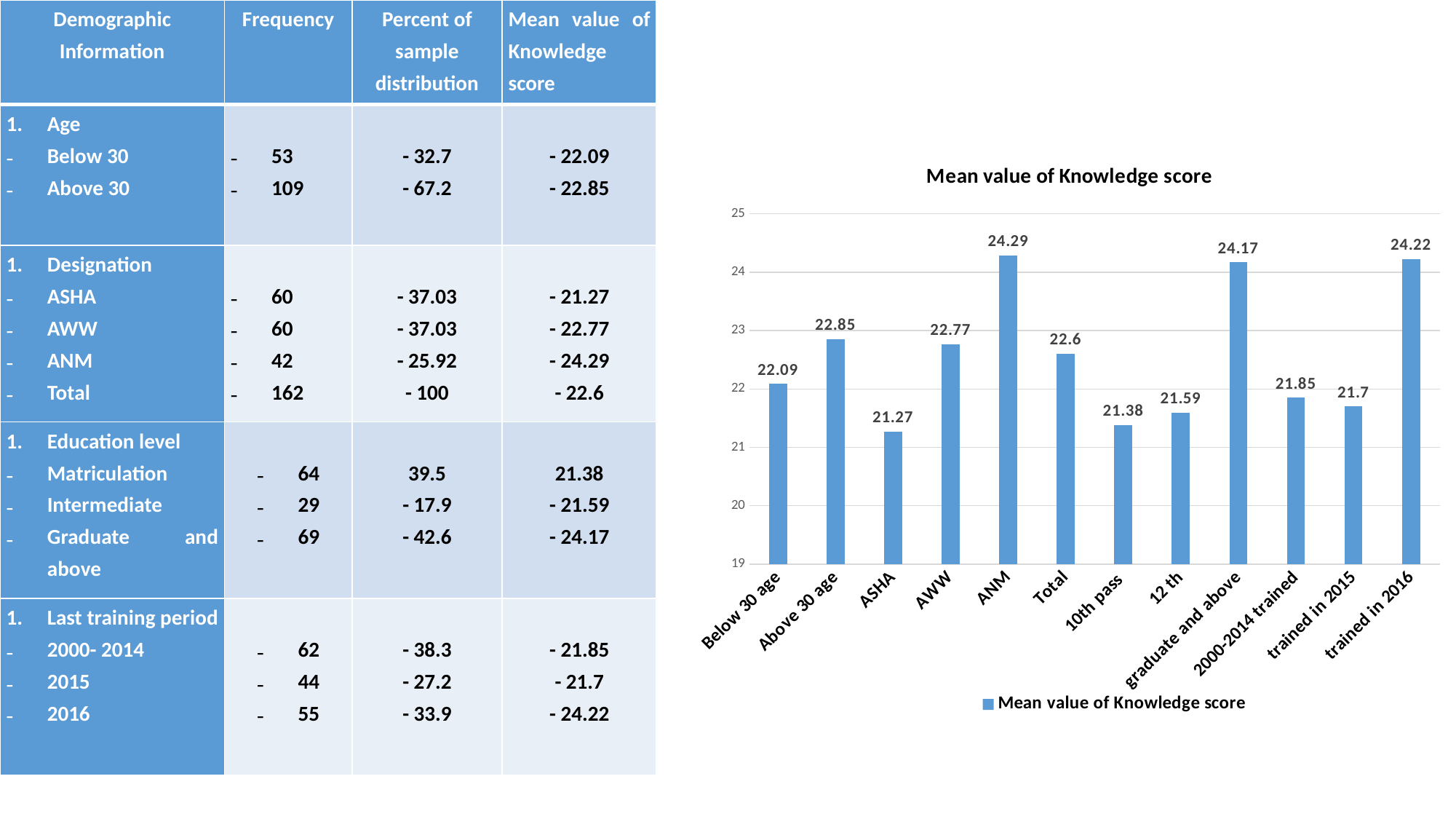
Which has a higher mean Knowledge score, AWW or ASHA? AWW Which category has the lowest mean value of Knowledge score in the chart? ASHA What type of chart is shown on the slide? bar chart How many series does the chart legend list? 1 What is the mean value of Knowledge score for 'Below 30 age' in the chart? 22.09 Which category has the highest mean value of Knowledge score in the chart? ANM What is the mean value of Knowledge score for ANM in the chart? 24.29 What is the mean value of Knowledge score for 'trained in 2016' in the chart? 24.22 How many categories are shown on the x axis of the chart? 12 Is the mean Knowledge score for '10th pass' greater or less than 22? less What is the difference between the mean Knowledge score for 'Above 30 age' and 'Below 30 age'? 0.76 What is the title of the chart? Mean value of Knowledge score